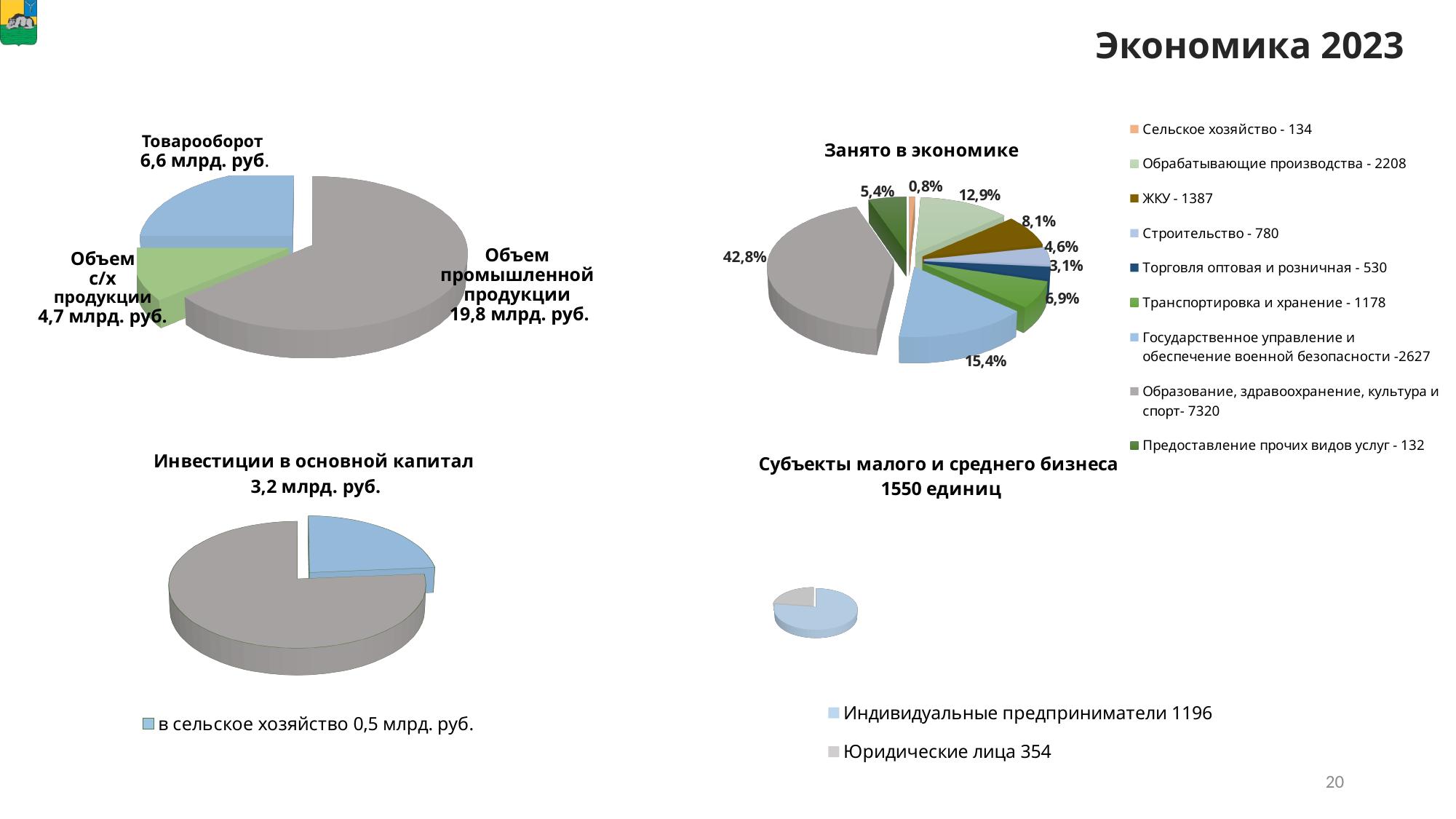
In the 'Занято в экономике' chart, what is the number of employees listed in the legend for Обрабатывающие производства? 2208 In the 'Инвестиции в основной капитал' chart, what value is given for investment в сельское хозяйство? 0,5 млрд. руб. In the 'Занято в экономике' chart, which category has the smallest share? Сельское хозяйство In the 'Занято в экономике' chart, what percentage is shown for the largest slice? 42,8% In the 'Занято в экономике' chart, which is larger: Строительство or Торговля оптовая и розничная? Строительство In the top-left pie chart, what is the value for Объем промышленной продукции? 19,8 млрд. руб. In the 'Субъекты малого и среднего бизнеса' chart, how many Индивидуальные предприниматели are listed? 1196 In the top-left pie chart, which category has the smallest value? Объем с/х продукции What kind of chart is 'Инвестиции в основной капитал'? Pie chart In the 'Субъекты малого и среднего бизнеса' chart, what is the difference between Индивидуальные предприниматели and Юридические лица? 842 In the top-left pie chart, what is the difference between Товарооборот and Объем с/х продукции? 1,9 млрд. руб. How many categories does the legend of the 'Занято в экономике' chart list? 9